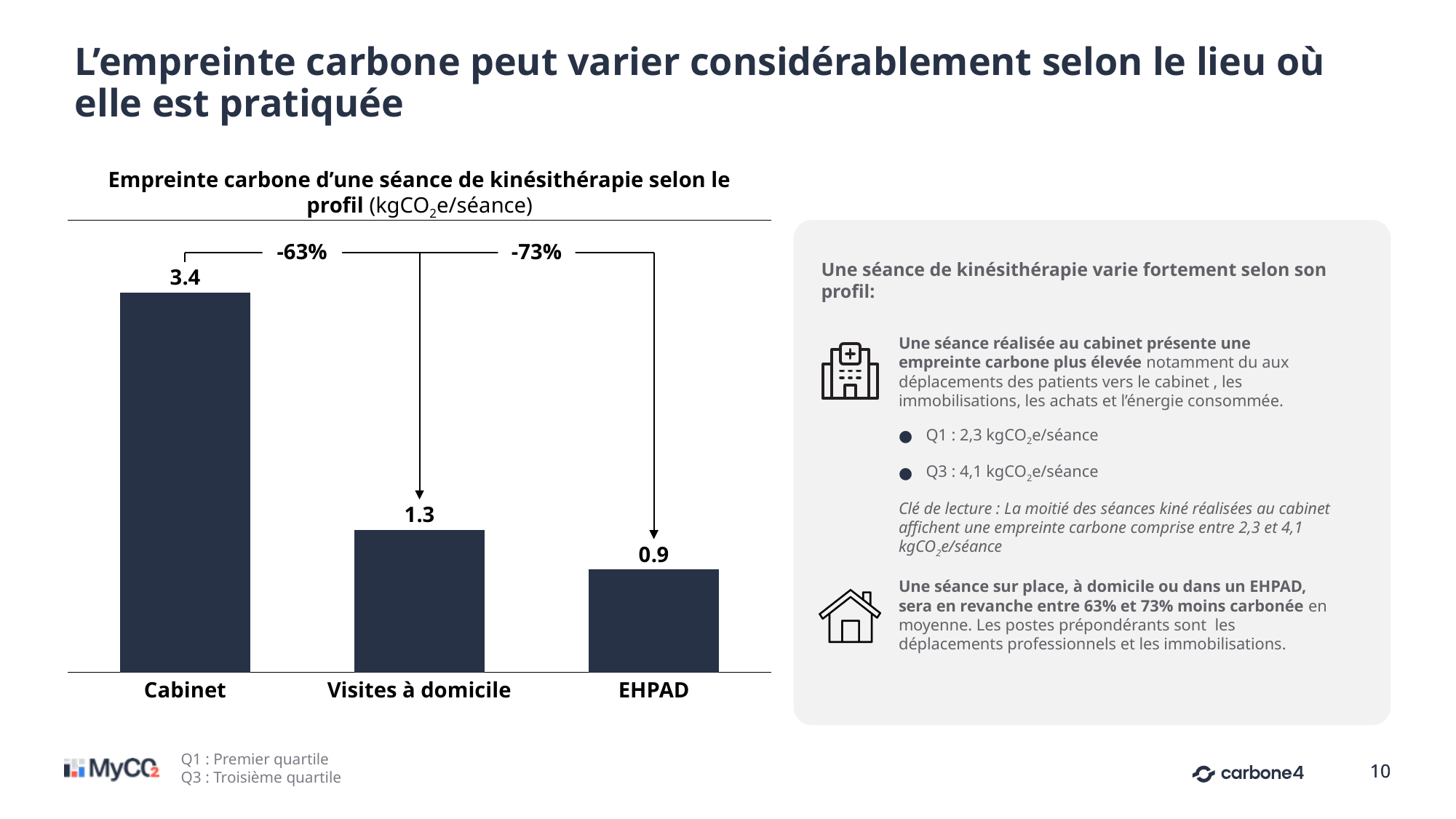
What is the difference between the Cabinet and Visites à domicile values? 2.1 Which is larger, the value for Visites à domicile or the value for EHPAD? Visites à domicile Which category has the lowest carbon footprint per session? EHPAD What is the carbon footprint value for Cabinet? 3.4 What is the carbon footprint value for EHPAD? 0.9 How many categories are shown in the chart? 3 What is the difference between the Cabinet and EHPAD values? 2.5 Which category has the highest carbon footprint per session? Cabinet What kind of chart is shown on the slide? Bar chart What is the carbon footprint value for Visites à domicile? 1.3 What percentage reduction is annotated between Cabinet and EHPAD? -73% Do the values rise or fall from left to right across the categories? Fall